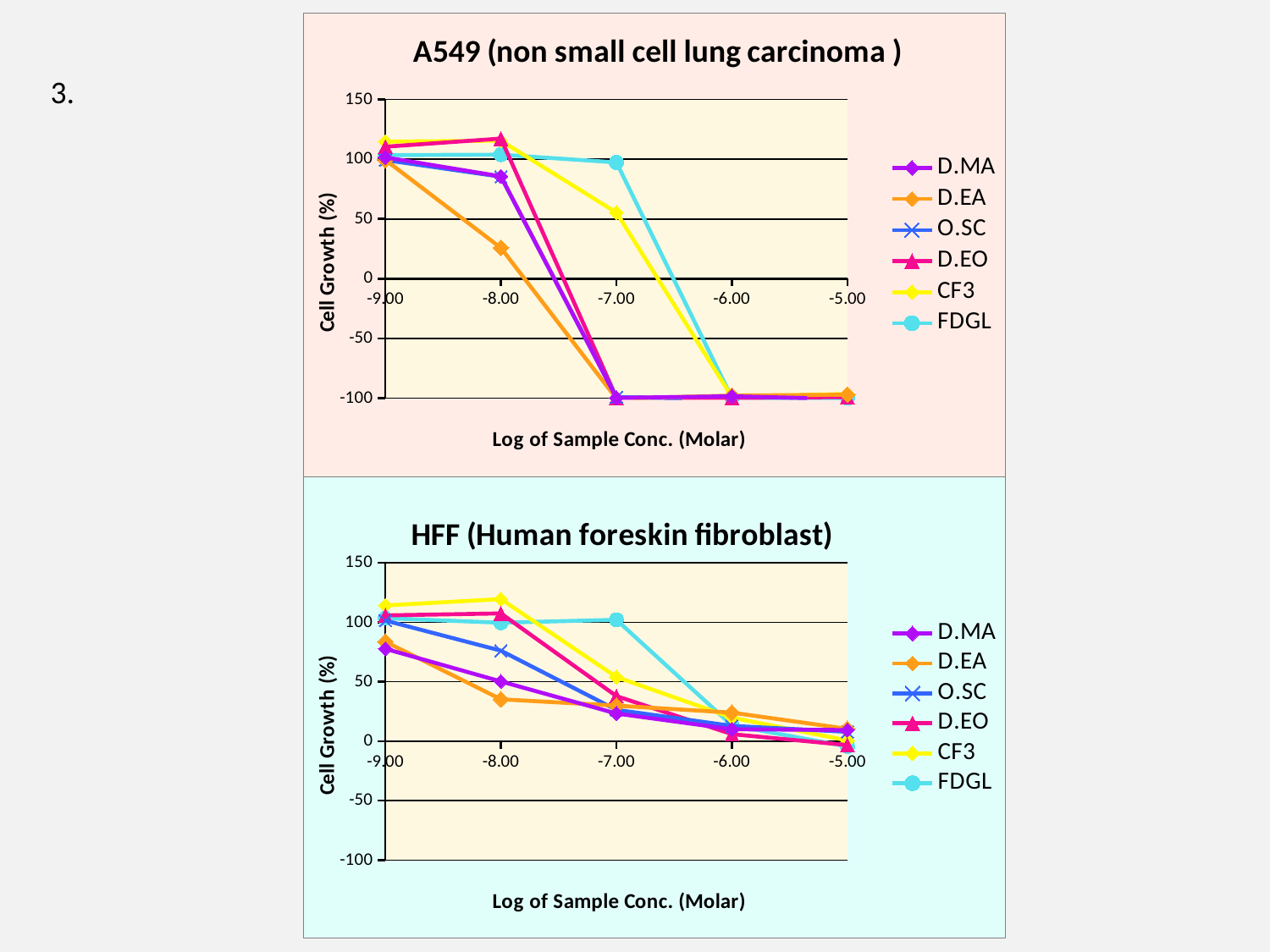
In the HFF (Human foreskin fibroblast) chart, which series has the highest value at -8.00? CF3 What kind of chart is the A549 (non small cell lung carcinoma) chart? line chart In the HFF (Human foreskin fibroblast) chart, is the value for FDGL at -7.00 greater or less than 50? greater What is the y-axis label of the HFF (Human foreskin fibroblast) chart? Cell Growth (%) How many x-axis points are plotted in the A549 (non small cell lung carcinoma) chart? 5 In the A549 (non small cell lung carcinoma) chart, do the values for D.MA rise or fall as the log of sample concentration increases from -9.00 to -5.00? fall In the A549 (non small cell lung carcinoma) chart, is the value for D.EA at -8.00 greater or less than 50? less In the A549 (non small cell lung carcinoma) chart, is the value for FDGL at -7.00 greater or less than 50? greater How many series does the legend of the HFF (Human foreskin fibroblast) chart list? 6 In the HFF (Human foreskin fibroblast) chart, which is larger at -8.00: CF3 or D.EA? CF3 In the HFF (Human foreskin fibroblast) chart, which series has the lowest value at -8.00? D.EA